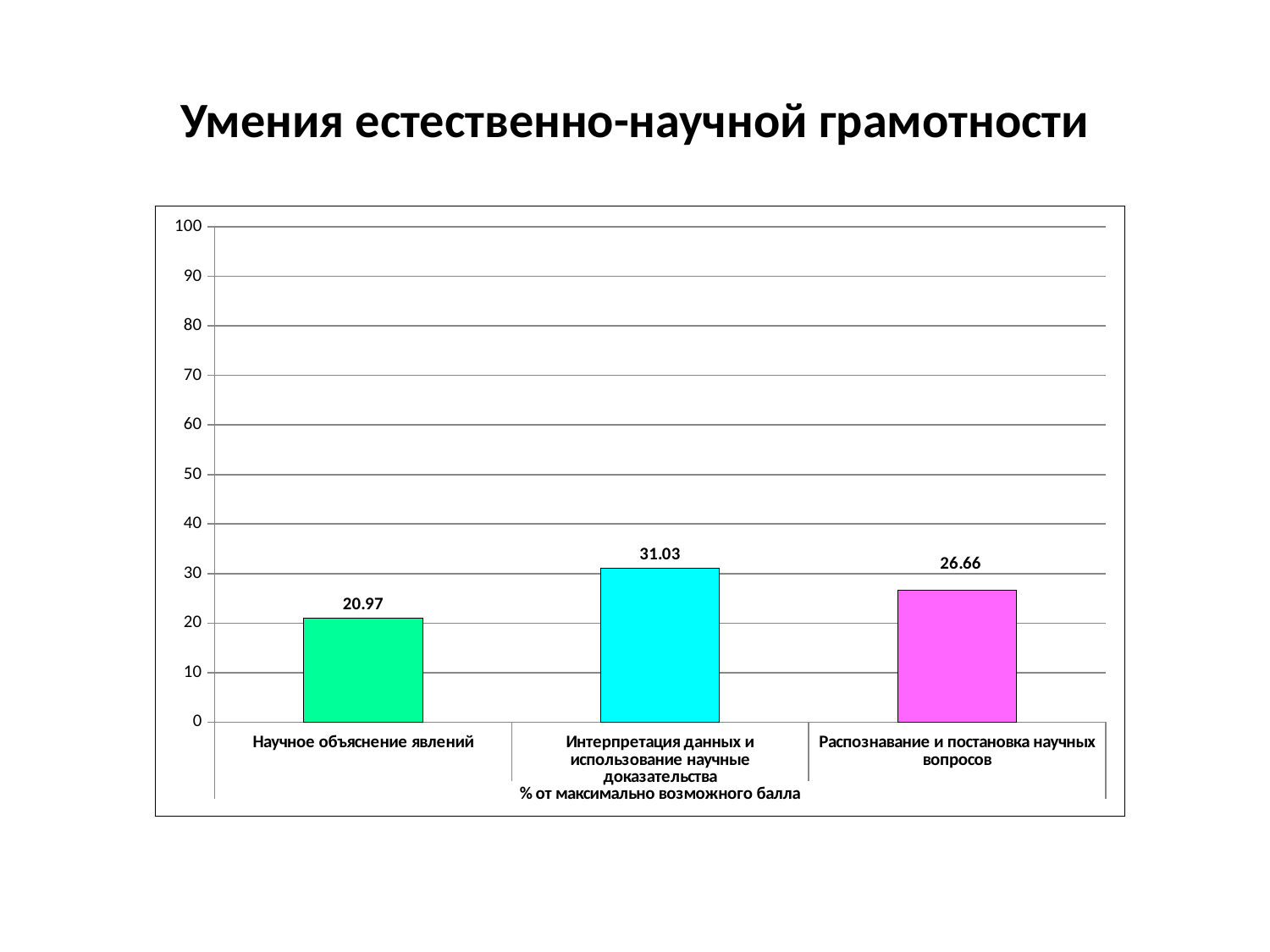
Which is larger: the value for «Распознавание и постановка научных вопросов» or the value for «Научное объяснение явлений»? Распознавание и постановка научных вопросов What is the difference between the values for «Распознавание и постановка научных вопросов» and «Научное объяснение явлений»? 5.69 What kind of chart is shown on the slide? bar chart How many categories are shown in the chart? 3 What is the difference between the values for «Интерпретация данных и использование научные доказательства» and «Научное объяснение явлений»? 10.06 What is the title of the slide? Умения естественно-научной грамотности What is the value for «Интерпретация данных и использование научные доказательства»? 31.03 Is the value for «Интерпретация данных и использование научные доказательства» greater or less than 30? greater Which category has the lowest value? Научное объяснение явлений What is the value for «Распознавание и постановка научных вопросов»? 26.66 Which category has the highest value? Интерпретация данных и использование научные доказательства What is the value for «Научное объяснение явлений»? 20.97